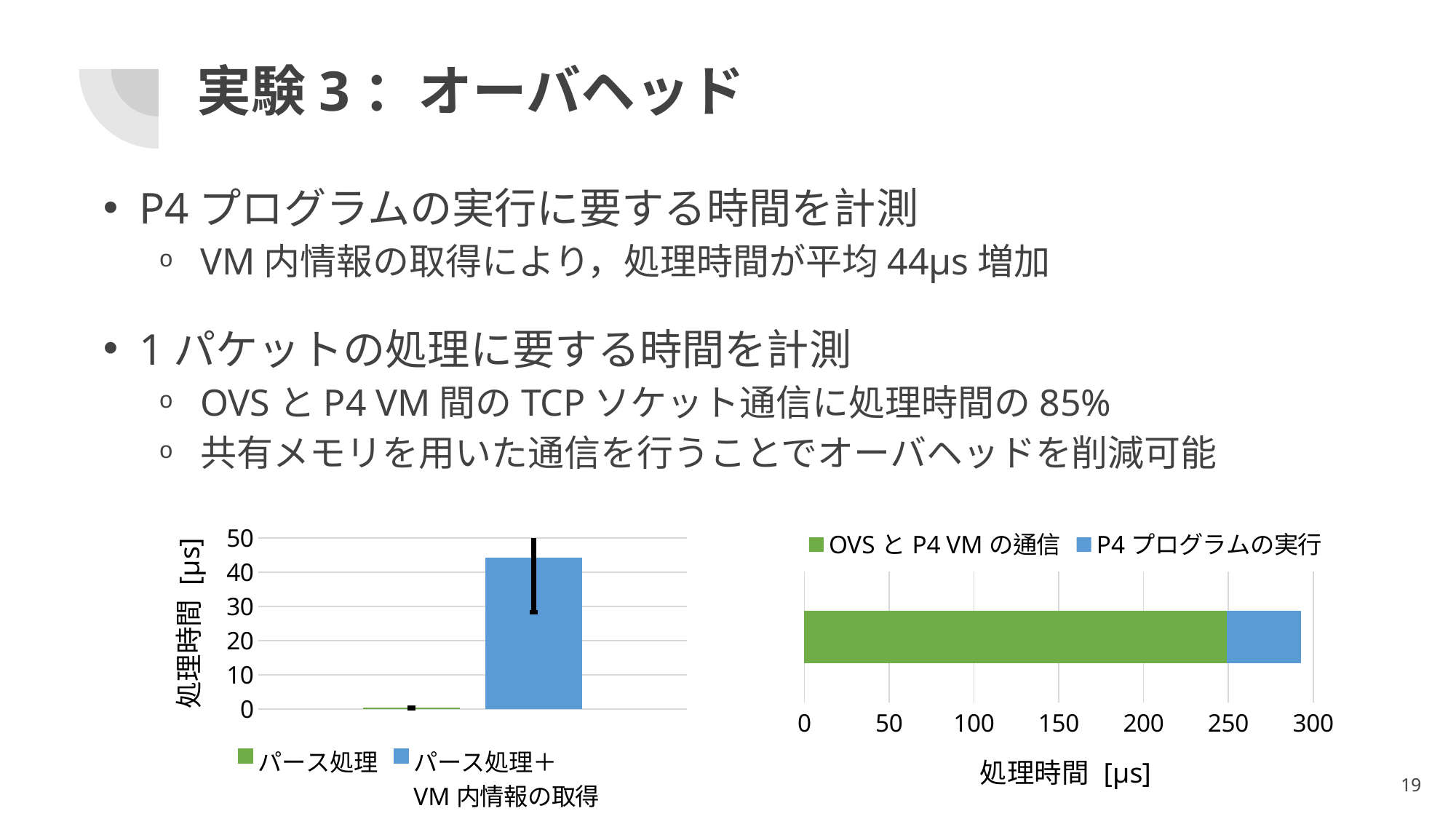
What kind of chart is the chart on the left of the slide? bar chart How many series does the legend of the right chart list? 2 In the left chart, is the value for パース処理 greater or less than 10? less In the right chart, which segment is larger, OVS と P4 VM の通信 or P4 プログラムの実行? OVS と P4 VM の通信 In the left chart, is the value for パース処理＋VM 内情報の取得 greater or less than 30? greater What kind of chart is the chart on the right of the slide? stacked bar chart What is the highest tick value shown on the horizontal axis of the right chart? 300 How many series does the legend of the left chart list? 2 In the right chart, is the value for OVS と P4 VM の通信 greater or less than 200? greater What is the label of the vertical axis of the left chart? 処理時間 [μs] In the left chart, which series has the larger value, パース処理 or パース処理＋VM 内情報の取得? パース処理＋VM 内情報の取得